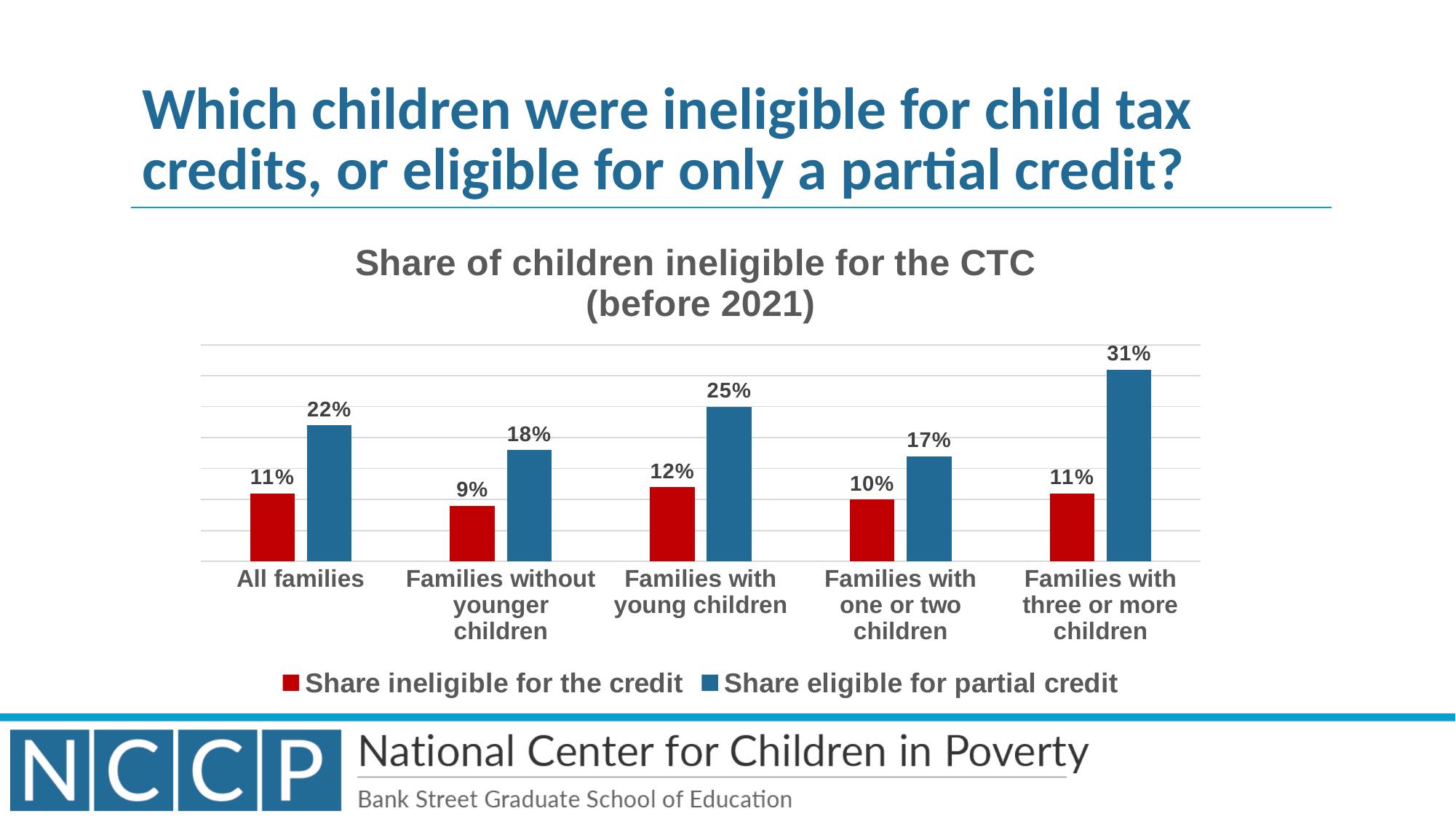
What is the share eligible for partial credit for families with three or more children? 31% Which category has the highest share eligible for partial credit? Families with three or more children What is the title of the chart? Share of children ineligible for the CTC (before 2021) How many series does the legend list? 2 Which is larger: the share eligible for partial credit for families with young children or for families without younger children? Families with young children What kind of chart is shown on the slide? Bar chart What is the difference between the share eligible for partial credit and the share ineligible for the credit for families with one or two children? 7% What is the share of children ineligible for the credit for families with young children? 12% Which category has the lowest share ineligible for the credit? Families without younger children Which colour represents the share ineligible for the credit? Red How many family categories are shown on the x axis? 5 What is the share eligible for partial credit for all families? 22%